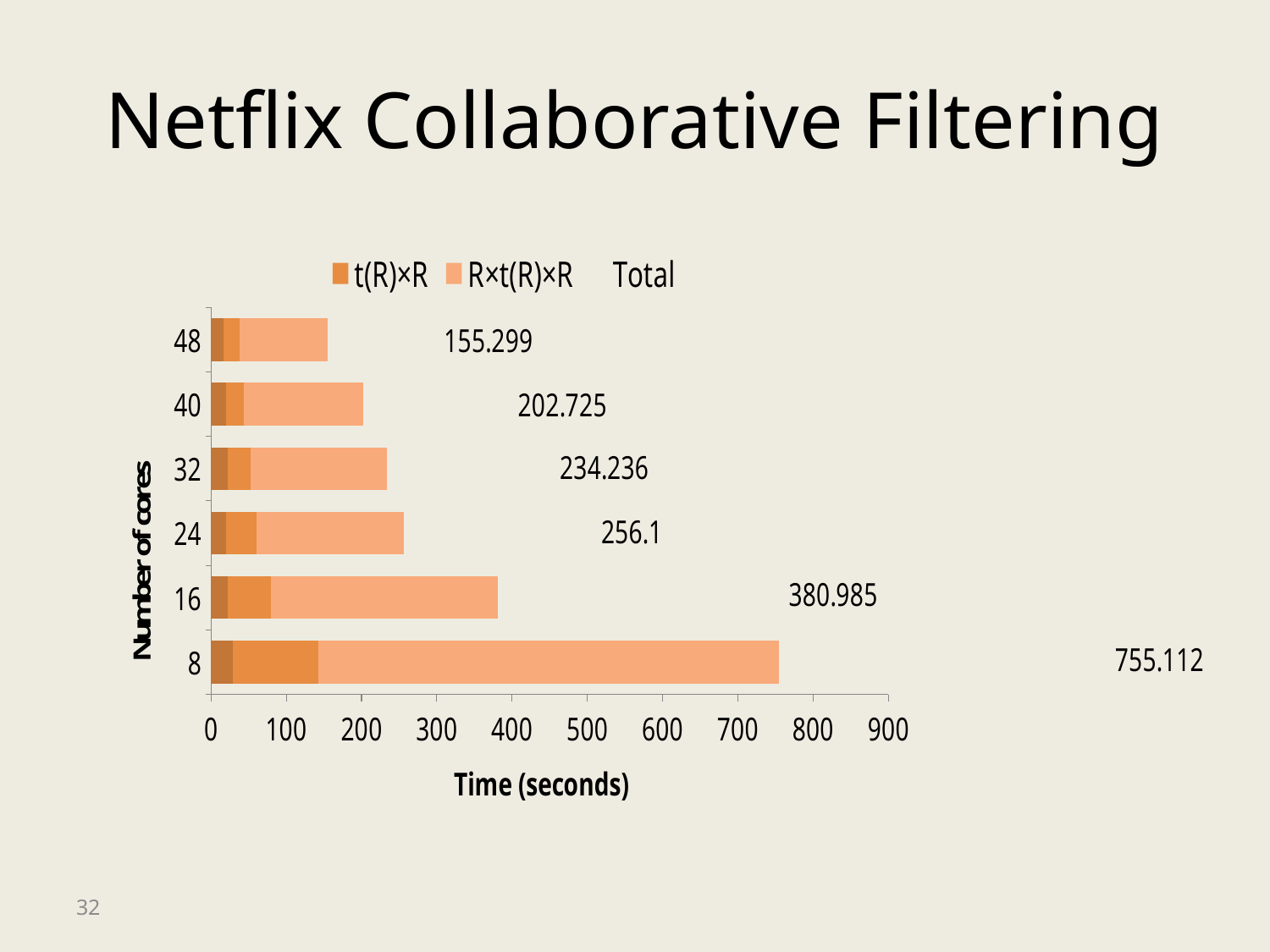
Which number of cores has the highest total time? 8 What is the total time in seconds for 24 cores? 256.1 How many core counts are shown on the chart? 6 Which number of cores has the lowest total time? 48 What kind of chart is shown on the slide? Stacked bar chart What is the total time in seconds for 8 cores? 755.112 Which has a larger total time, 32 cores or 40 cores? 32 cores Is the t(R)×R value for 8 cores greater or less than 200? less What is the difference between the total time for 8 cores and the total time for 16 cores? 374.127 What is the total time in seconds for 48 cores? 155.299 What is the label of the horizontal axis? Time (seconds) How many entries does the legend list? 3